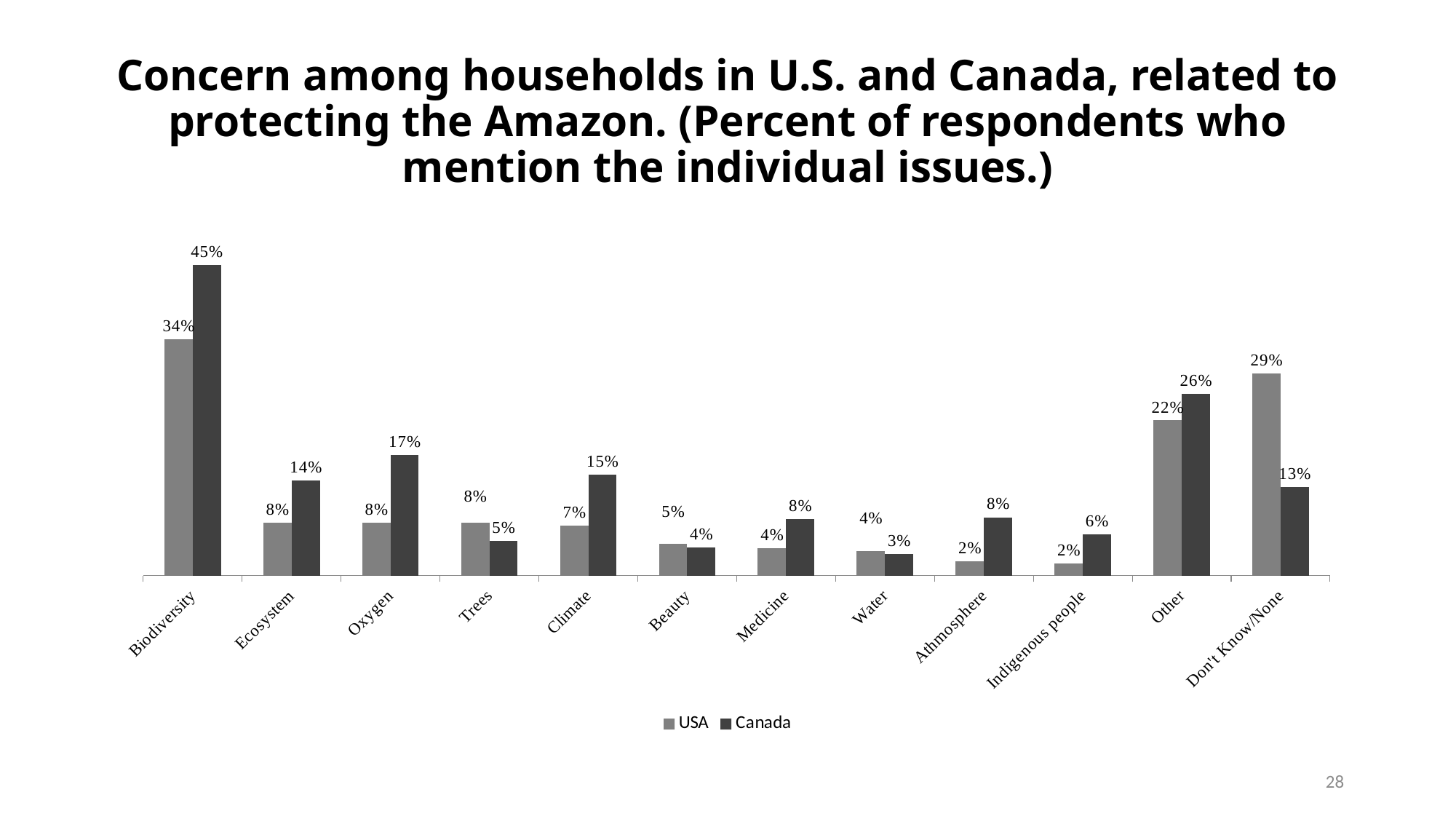
What is the difference between the Canada and USA values for Biodiversity? 11% Which category has the highest Canada value? Biodiversity What is the Canada value for Don't Know/None? 13% How many categories are shown on the x axis? 12 Which category has the highest USA value? Biodiversity What kind of chart is shown on the slide? Bar chart Which is larger for Oxygen, the USA value or the Canada value? Canada What is the difference between the USA and Canada values for Don't Know/None? 16% How many series does the legend list? 2 What percentage of Canada respondents mentioned Climate? 15% Which is larger for Trees, the USA value or the Canada value? USA What percentage of USA respondents mentioned Biodiversity? 34%